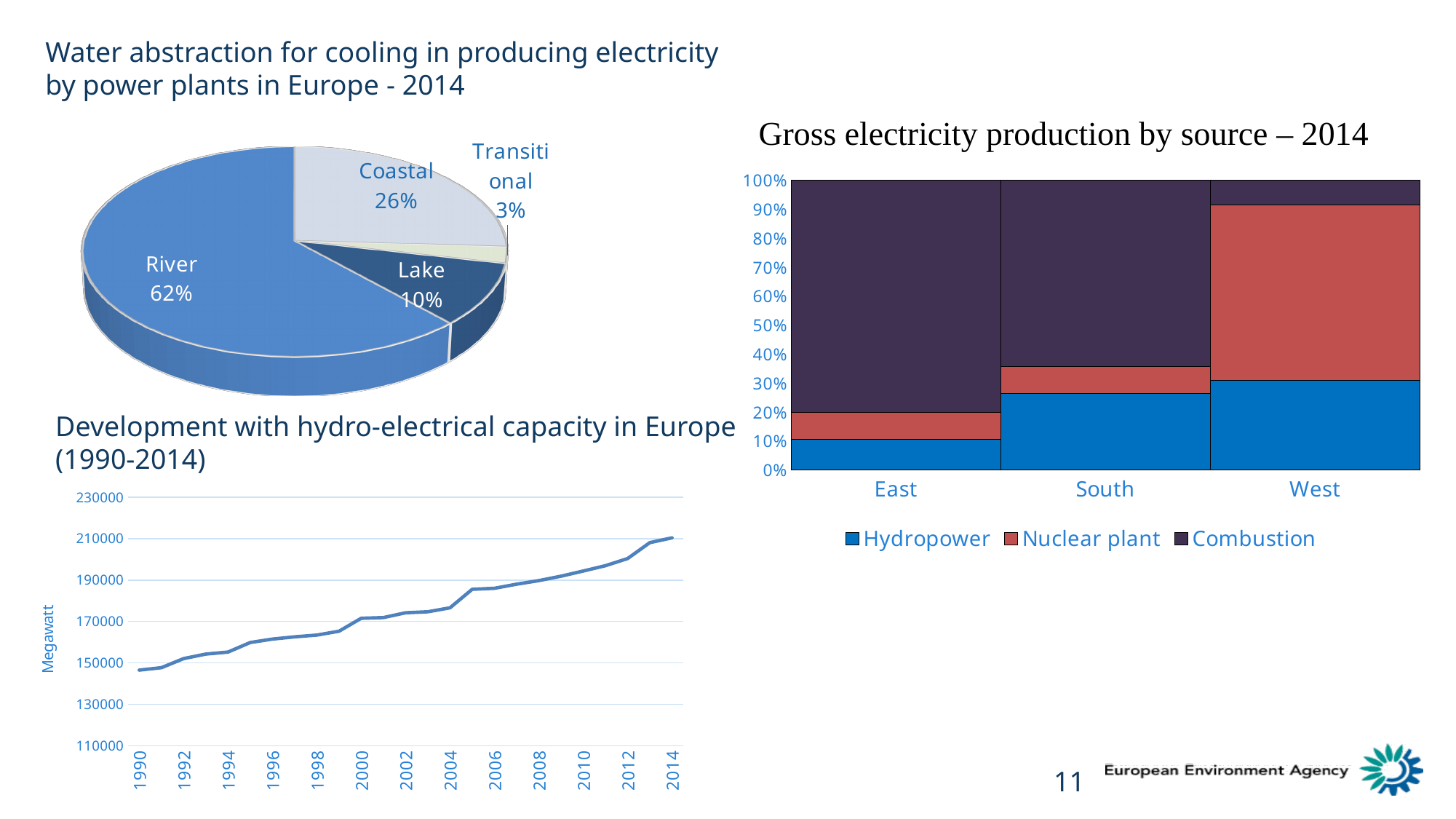
In the pie chart on water abstraction for cooling, how many slices are there? 4 In the chart 'Gross electricity production by source – 2014', which is larger, the Nuclear plant share for West or for East? West In the pie chart on water abstraction for cooling, what share is Coastal? 26% In the chart 'Gross electricity production by source – 2014', which region has the largest Combustion share? East In the chart 'Development with hydro-electrical capacity in Europe (1990-2014)', is the value for 1990 greater or less than 150000? less In the pie chart on water abstraction for cooling, what share is River? 62% In the pie chart on water abstraction for cooling, which source has the smallest share? Transitional In the chart 'Development with hydro-electrical capacity in Europe (1990-2014)', do values rise or fall from 1990 to 2014? rise In the chart 'Gross electricity production by source – 2014', how many series does the legend list? 3 In the chart 'Gross electricity production by source – 2014', is the Hydropower share for South greater or less than 30%? less In the chart 'Development with hydro-electrical capacity in Europe (1990-2014)', what kind of chart is shown? line chart In the pie chart on water abstraction for cooling, what is the difference between the River and Lake shares? 52%